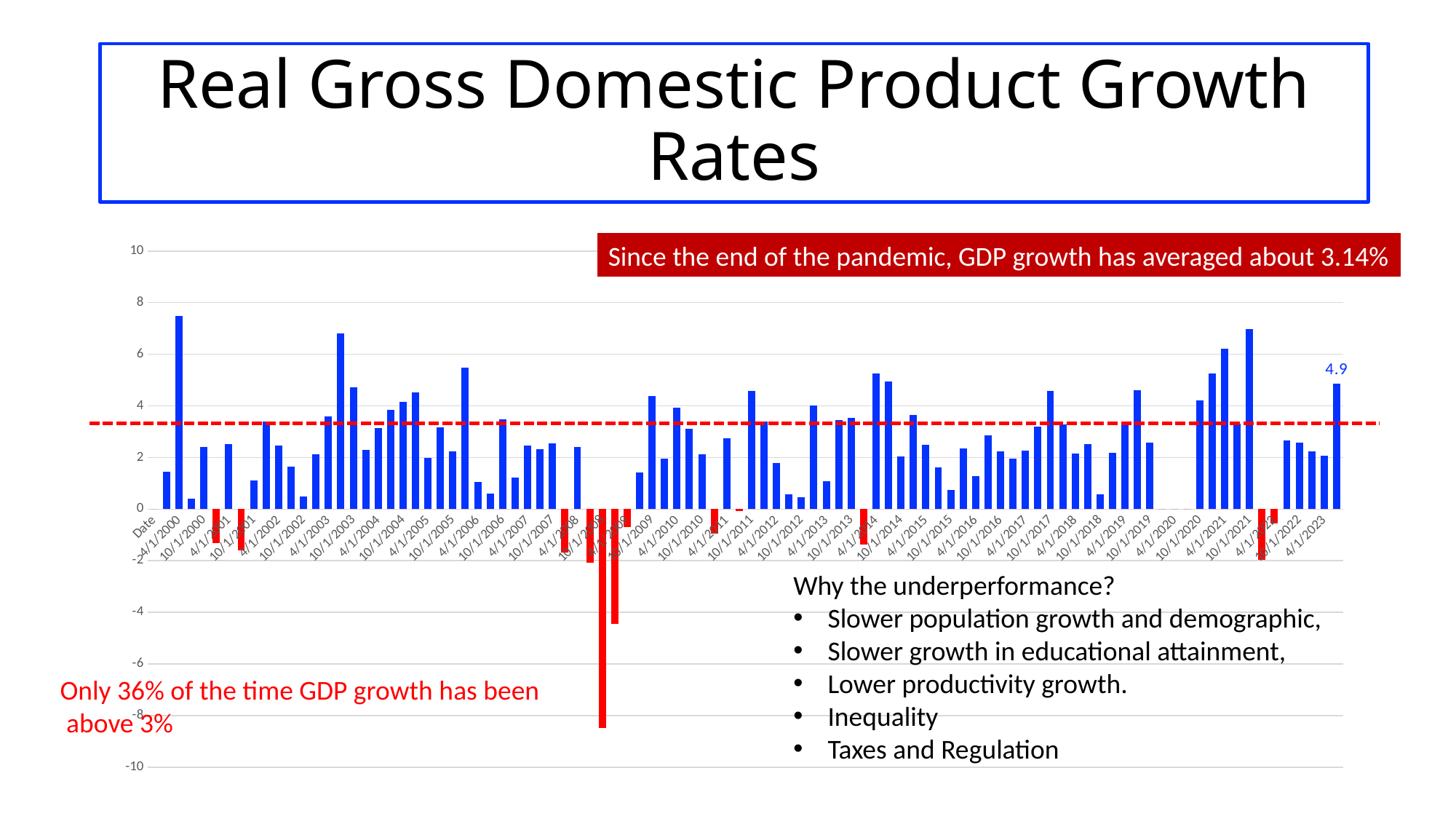
Is the value of the lowest (most negative) bar in the chart greater or less than -6? less What kind of chart is shown on the slide? bar chart What colour are the bars with negative values in the chart? red Is the value of the last (rightmost) bar, labeled 4.9, greater or less than 4? greater What is the value printed on the last (rightmost) bar of the chart? 4.9 Is the value of the tallest bar in the chart greater or less than 6? greater What is the title of the slide containing the chart? Real Gross Domestic Product Growth Rates